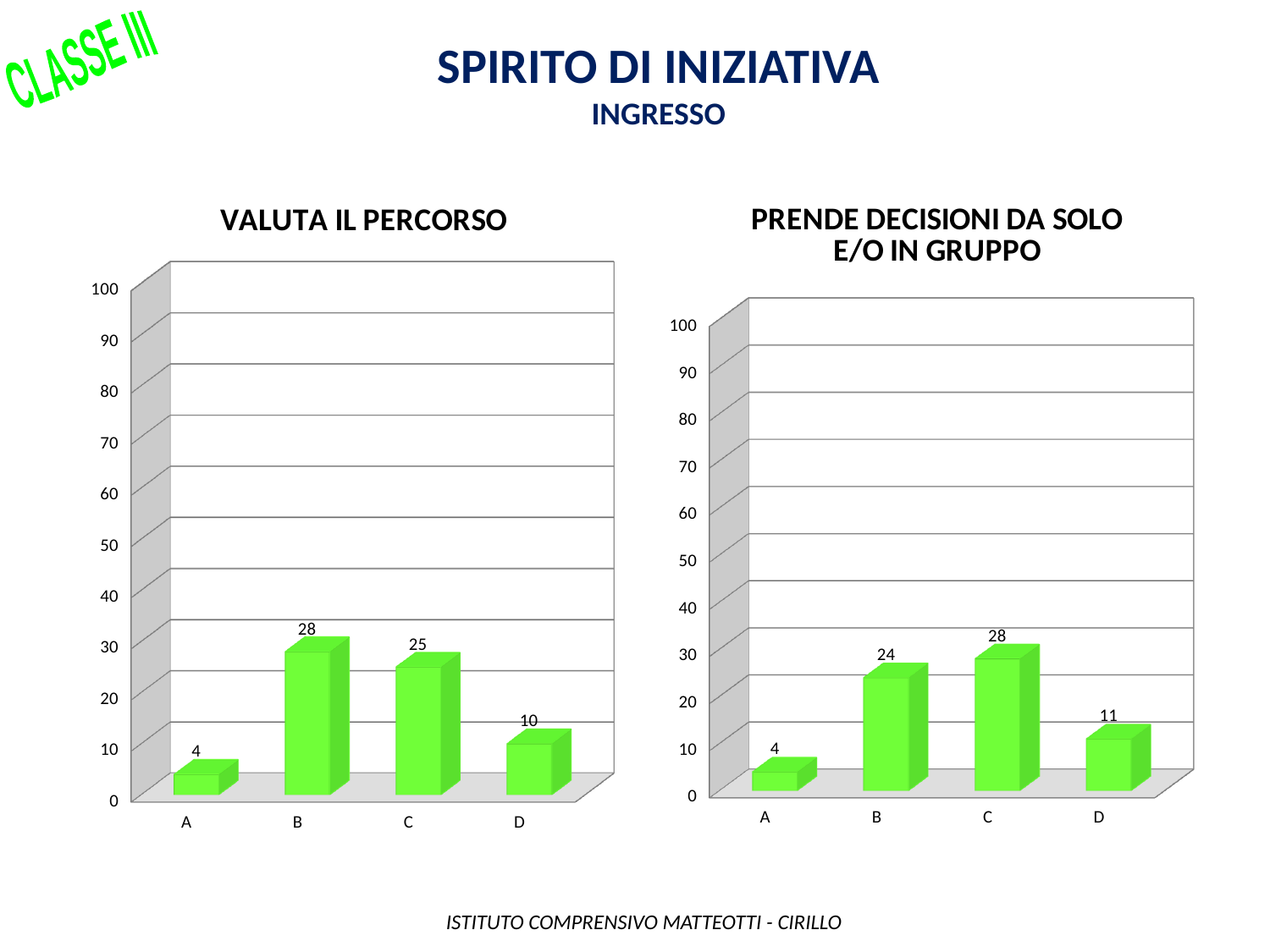
In the 'VALUTA IL PERCORSO' chart, what is the difference between the values for B and C? 3 In the 'PRENDE DECISIONI DA SOLO E/O IN GRUPPO' chart, what is the difference between the values for C and B? 4 In the 'VALUTA IL PERCORSO' chart, what is the value for category B? 28 What kind of chart is 'PRENDE DECISIONI DA SOLO E/O IN GRUPPO'? bar chart In the 'PRENDE DECISIONI DA SOLO E/O IN GRUPPO' chart, what is the value for category D? 11 What is the title of the chart on the left side of the slide? VALUTA IL PERCORSO How many categories are shown in the 'VALUTA IL PERCORSO' chart? 4 In the 'PRENDE DECISIONI DA SOLO E/O IN GRUPPO' chart, which category has the lowest value? A In the 'VALUTA IL PERCORSO' chart, which category has the highest value? B In the 'PRENDE DECISIONI DA SOLO E/O IN GRUPPO' chart, what is the value for category A? 4 In the 'PRENDE DECISIONI DA SOLO E/O IN GRUPPO' chart, which is larger, the value for B or the value for C? C In the 'VALUTA IL PERCORSO' chart, is the value for D greater or less than 20? less